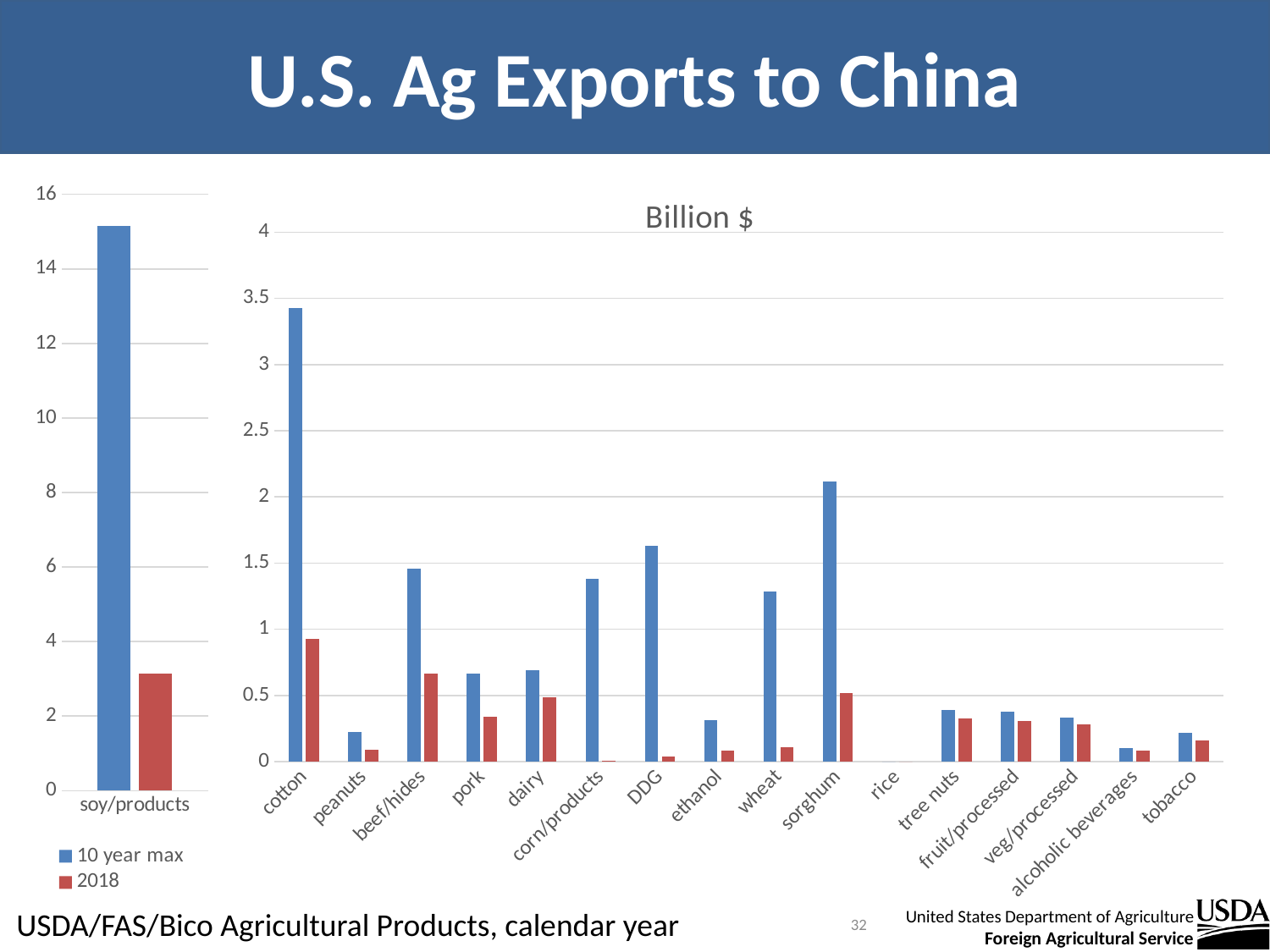
How many series does the legend on the slide list? 2 On the right chart titled "Billion $", is the 2018 value for cotton greater or less than 1? less On the right chart titled "Billion $", is the 10 year max value for wheat greater or less than 1.5? less On the left chart, is the 2018 value for soy/products greater or less than 4? less What is the title of the slide? U.S. Ag Exports to China On the right chart titled "Billion $", how many product categories are shown on the x axis? 16 On the right chart titled "Billion $", which is larger: the 2018 value for cotton or the 2018 value for beef/hides? cotton On the right chart titled "Billion $", which is larger: the 10 year max value for sorghum or the 10 year max value for DDG? sorghum What kind of chart is the right chart titled "Billion $"? bar chart On the right chart titled "Billion $", which category has the highest 10 year max value? cotton